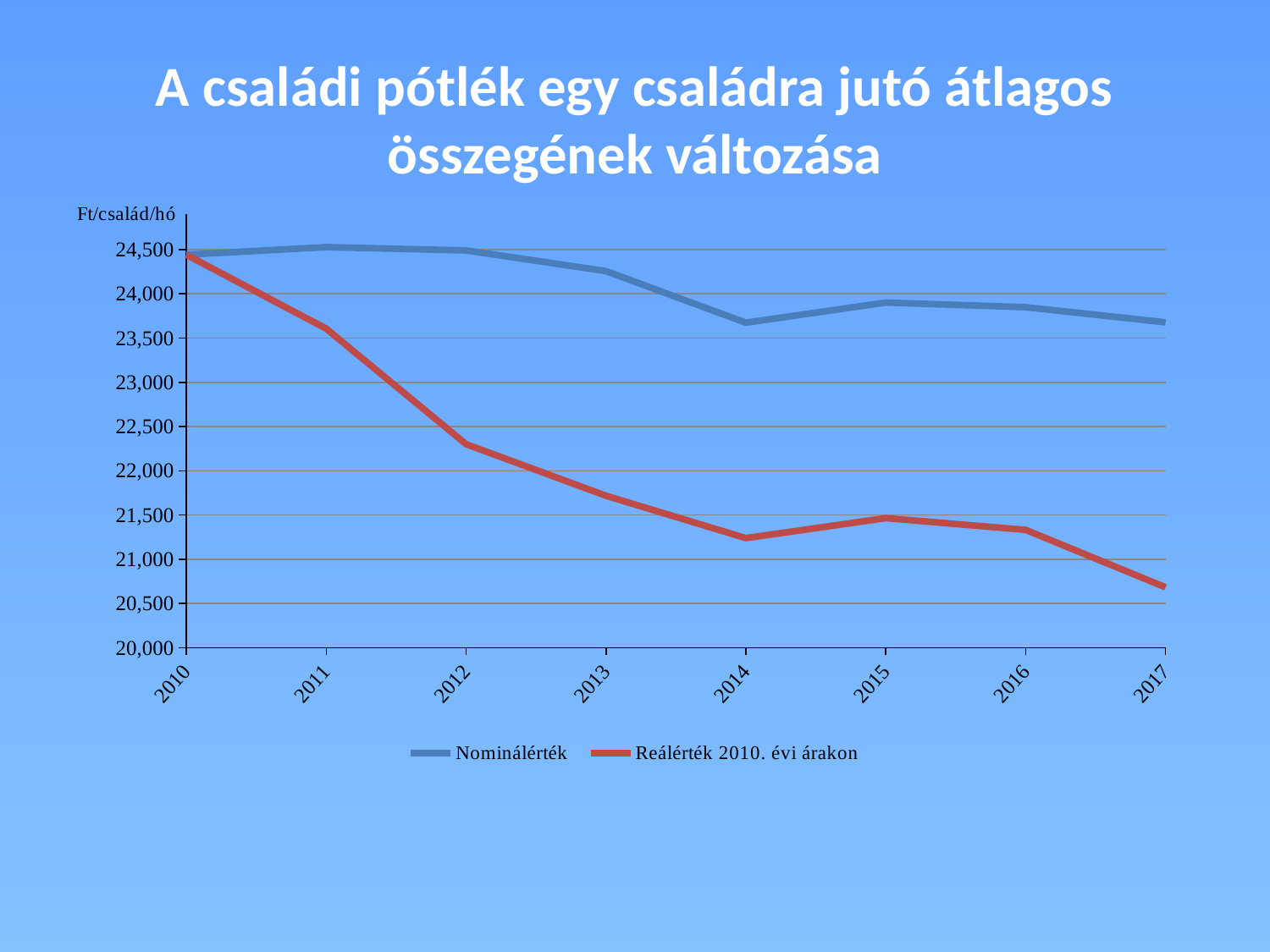
Does the Reálérték 2010. évi árakon series rise or fall overall from 2010 to 2017? fall How many series does the legend list? 2 Is the value for Reálérték 2010. évi árakon in 2017 greater or less than 21,000? less In which year is the Reálérték 2010. évi árakon series at its highest? 2010 What unit is shown on the vertical axis of the chart? Ft/család/hó What kind of chart is shown on the slide? line chart For the Reálérték 2010. évi árakon series, which year has the larger value, 2013 or 2015? 2013 Is the value for Nominálérték in 2017 greater or less than 23,500? greater How many years are plotted along the x axis? 8 Is the value for Reálérték 2010. évi árakon in 2012 greater or less than 22,000? greater In 2017, which series has the larger value, Nominálérték or Reálérték 2010. évi árakon? Nominálérték In which year is the Reálérték 2010. évi árakon series at its lowest? 2017